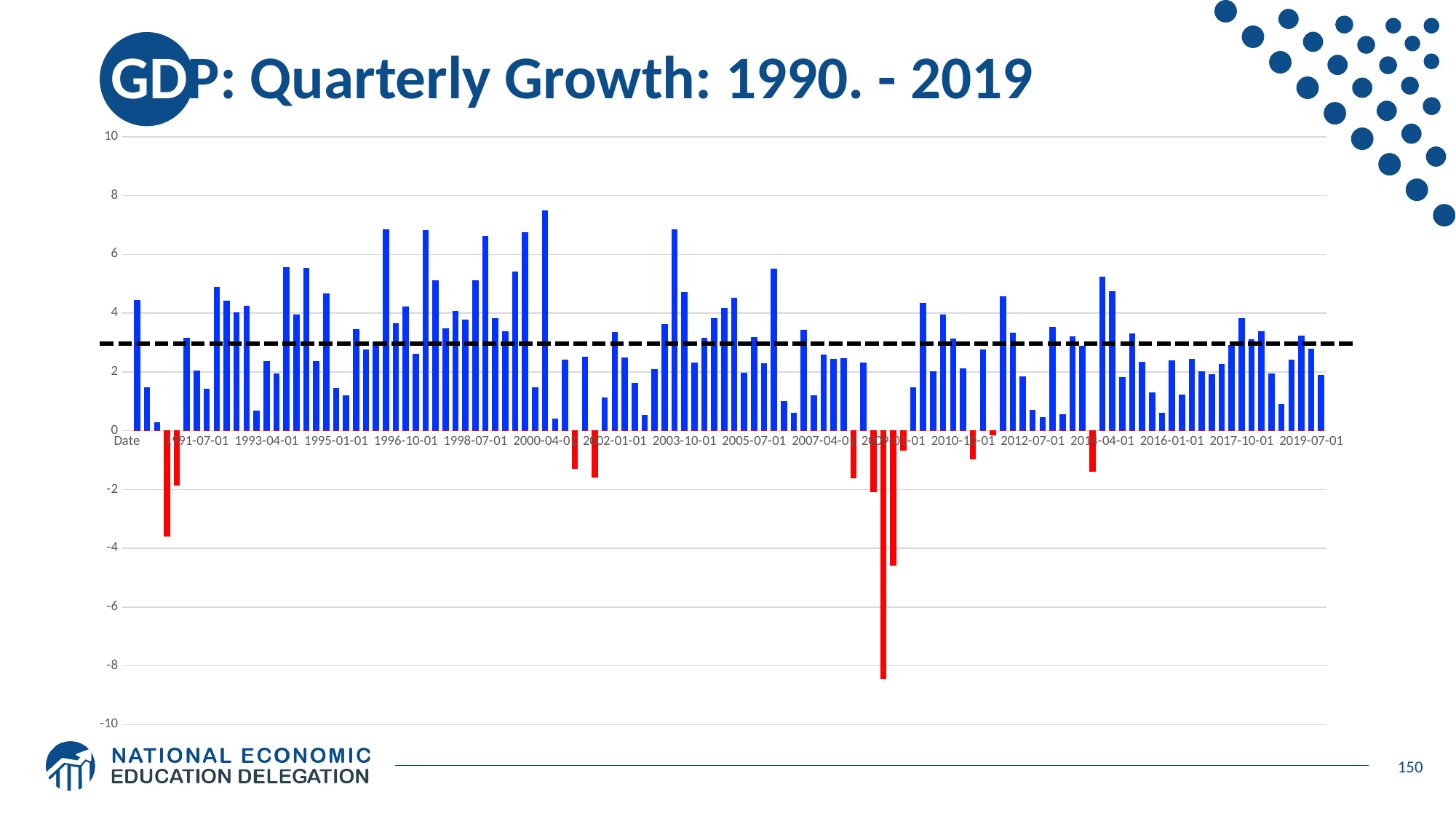
What colour are the bars with negative values? red Is the value of the tallest red bar near 1991-07-01 greater or less than -2? less Is the value of the lowest bar on the chart greater or less than -8? less Near which x-axis date label does the lowest bar on the chart occur? 2009-01-01 What kind of chart is shown on the slide? bar chart Is the dashed horizontal line on the chart above or below the value 2 on the y axis? above What is the last date label shown on the x axis? 2019-07-01 What is the lowest value shown on the y axis? -10 What is the highest value shown on the y axis? 10 What is the title of the chart? GDP: Quarterly Growth: 1990. - 2019